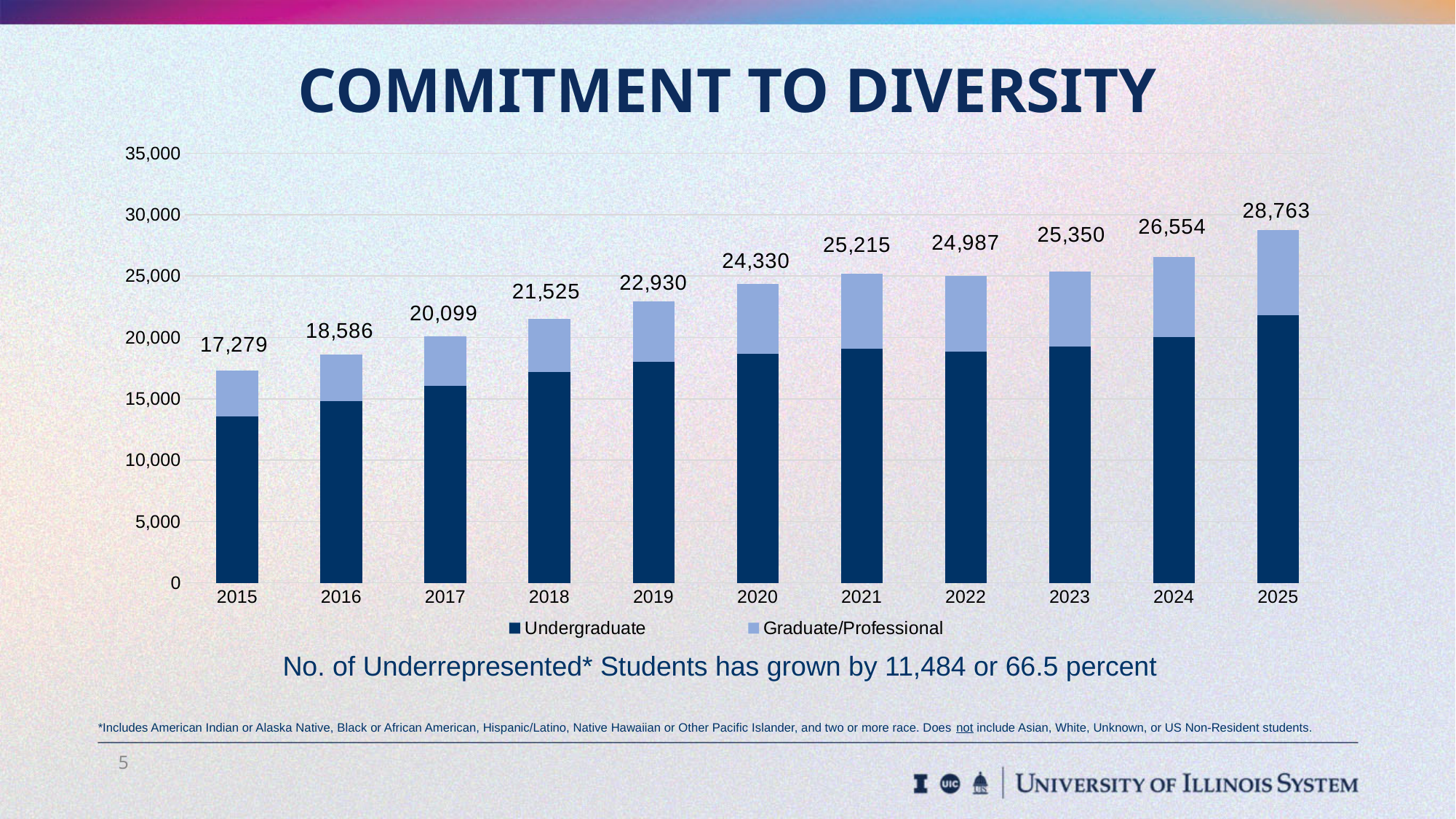
How many years are shown on the x axis of the chart? 11 What is the difference between the total for 2024 and the total for 2023? 1,204 What type of chart is shown on the slide? Stacked bar chart What is the total number of underrepresented students shown for 2015? 17,279 What is the total number of underrepresented students shown for 2020? 24,330 What is the difference between the total for 2025 and the total for 2015? 11,484 Is the Undergraduate value for 2015 greater or less than 15,000? less How many series does the chart legend list? 2 Which year has the lowest total number of underrepresented students? 2015 Which year has a larger total, 2021 or 2022? 2021 What is the total number of underrepresented students shown for 2025? 28,763 Which year has the highest total number of underrepresented students? 2025